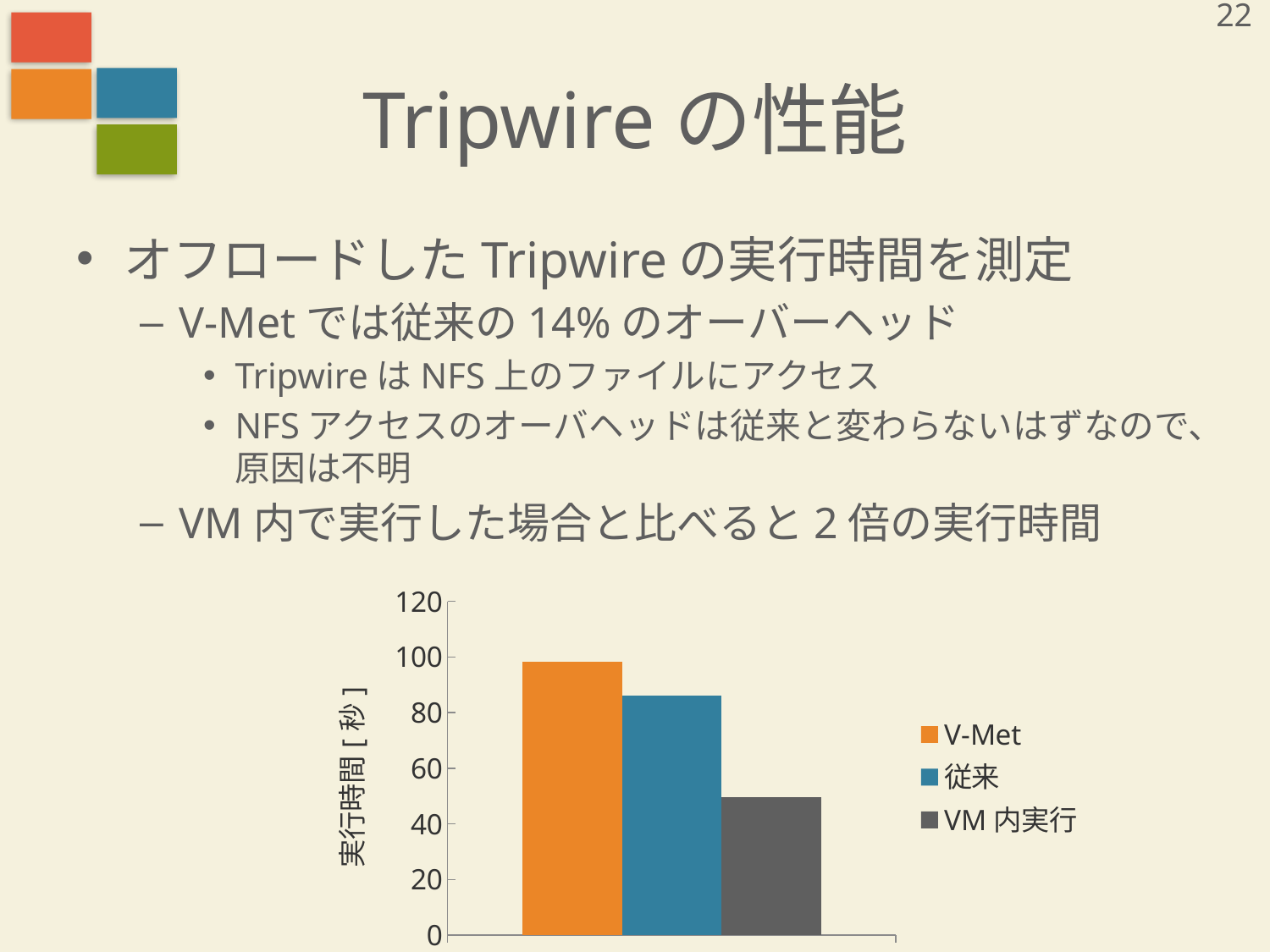
Which is larger, the bar for 従来 or the bar for VM 内実行? 従来 Which series has the highest bar in the chart? V-Met Which series has the lowest bar in the chart? VM 内実行 Is the value for V-Met greater or less than 80? greater Is the value for VM 内実行 greater or less than 60? less What is the label of the vertical axis of the chart? 実行時間 [ 秒 ] Is the value for 従来 greater or less than 100? less What kind of chart is shown on the slide? bar chart What colour is the bar for VM 内実行 in the chart? gray Which is larger, the bar for V-Met or the bar for 従来? V-Met How many series does the chart legend list? 3